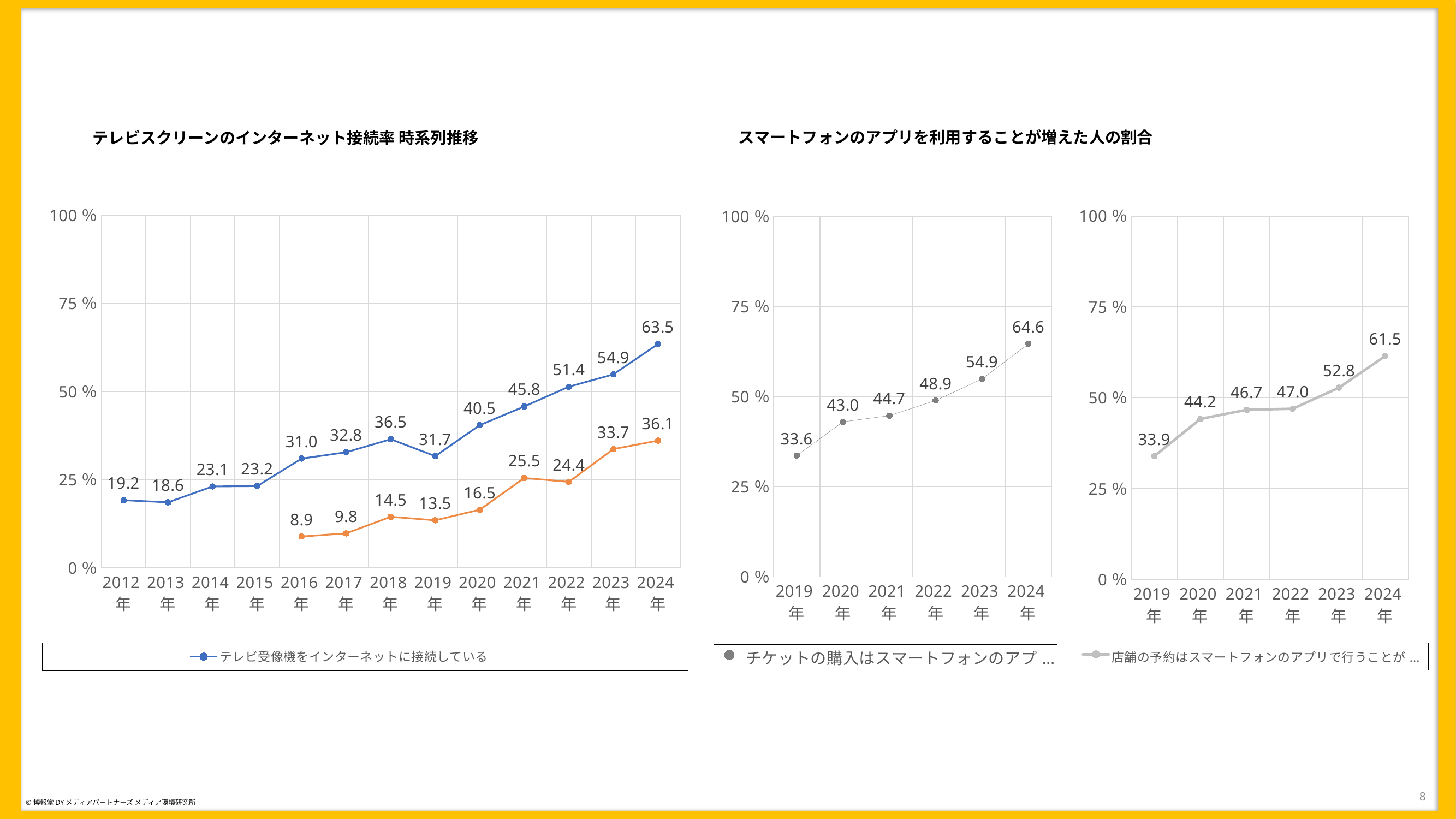
What kind of chart is the middle chart (チケットの購入はスマートフォンのアプ...)? line chart In the left chart titled テレビスクリーンのインターネット接続率 時系列推移, what is the value of the blue line for 2012年? 19.2 In the right chart (店舗の予約はスマートフォンのアプリで行うことが...), what is the value for 2022年? 47.0 In the middle chart (チケットの購入はスマートフォンのアプ...), what is the value for 2019年? 33.6 In the left chart titled テレビスクリーンのインターネット接続率 時系列推移, what is the value of the orange line for 2016年? 8.9 In the right chart (店舗の予約はスマートフォンのアプリで行うことが...), do the values generally rise or fall from 2019年 to 2024年? rise In the left chart titled テレビスクリーンのインターネット接続率 時系列推移, what is the value of the blue line (テレビ受像機をインターネットに接続している) for 2024年? 63.5 In the left chart titled テレビスクリーンのインターネット接続率 時系列推移, how many years are shown on the x axis? 13 In the middle chart (チケットの購入はスマートフォンのアプ...), what is the difference between the 2024年 and 2023年 values? 9.7 In the left chart titled テレビスクリーンのインターネット接続率 時系列推移, what is the difference between the blue line and the orange line in 2024年? 27.4 In the left chart titled テレビスクリーンのインターネット接続率 時系列推移, in which year is the blue line at its lowest? 2013年 In the left chart titled テレビスクリーンのインターネット接続率 時系列推移, is the blue line's value for 2018年 greater or less than the value for 2019年? greater